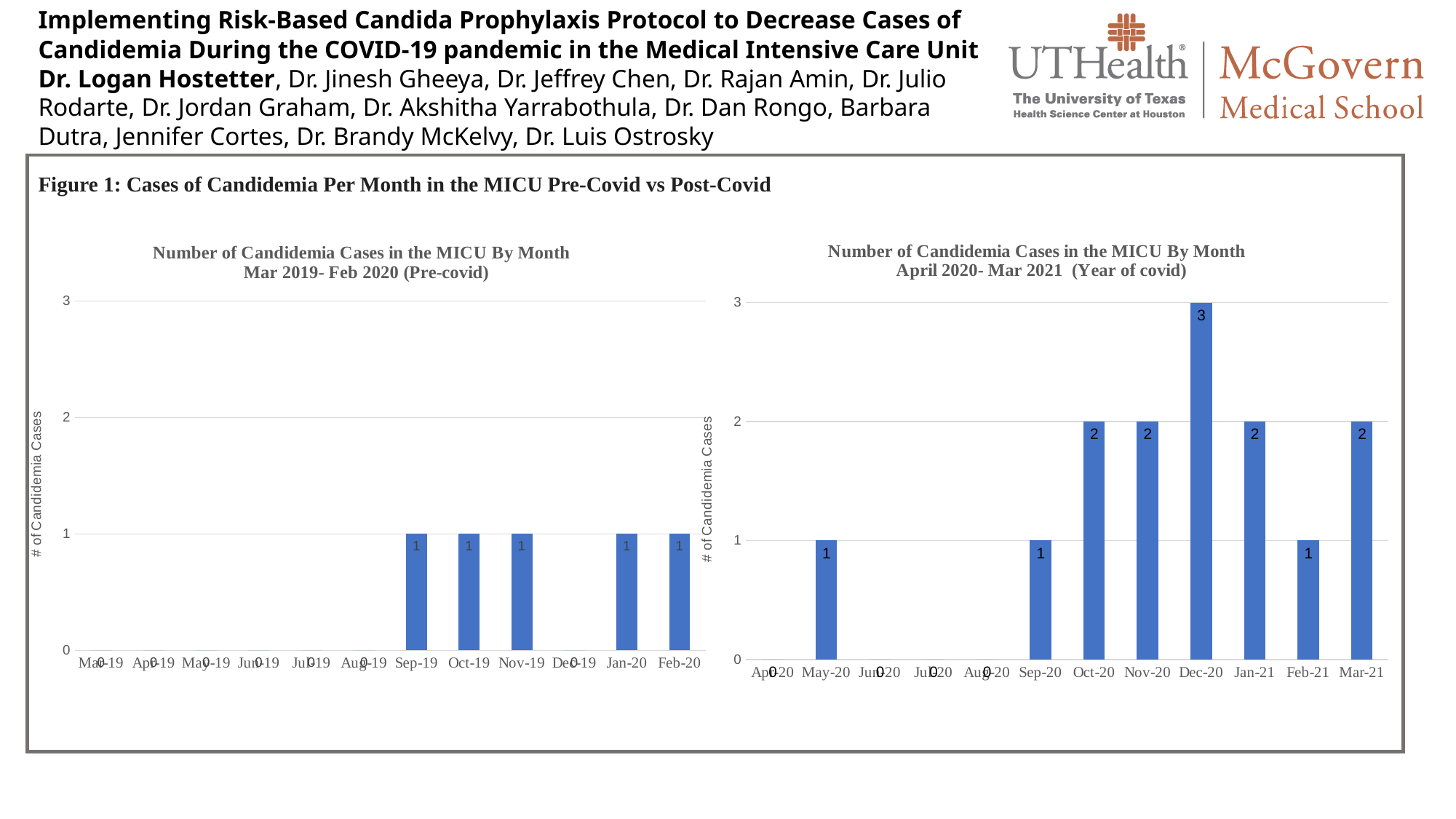
What type of chart is the right chart (April 2020 - Mar 2021)? Bar chart In the right chart (April 2020 - Mar 2021), which month has the highest number of candidemia cases? Dec-20 In the right chart (April 2020 - Mar 2021), which has more candidemia cases, Oct-20 or Sep-20? Oct-20 In the right chart (April 2020 - Mar 2021), what is the number of candidemia cases in Dec-20? 3 In the left chart (Mar 2019 - Feb 2020), what is the number of candidemia cases in Sep-19? 1 In the left chart (Mar 2019 - Feb 2020), how many cases are shown for Dec-19? 0 In the right chart (April 2020 - Mar 2021), what is the difference in cases between Mar-21 and Feb-21? 1 In the right chart (April 2020 - Mar 2021), what is the number of candidemia cases in May-20? 1 In the right chart (April 2020 - Mar 2021), what is the number of candidemia cases in Feb-21? 1 How many months are shown on the x axis of the left chart (Mar 2019 - Feb 2020)? 12 What is the label of the y axis on the left chart (Mar 2019 - Feb 2020)? # of Candidemia Cases In the right chart (April 2020 - Mar 2021), what is the difference in cases between Dec-20 and Nov-20? 1